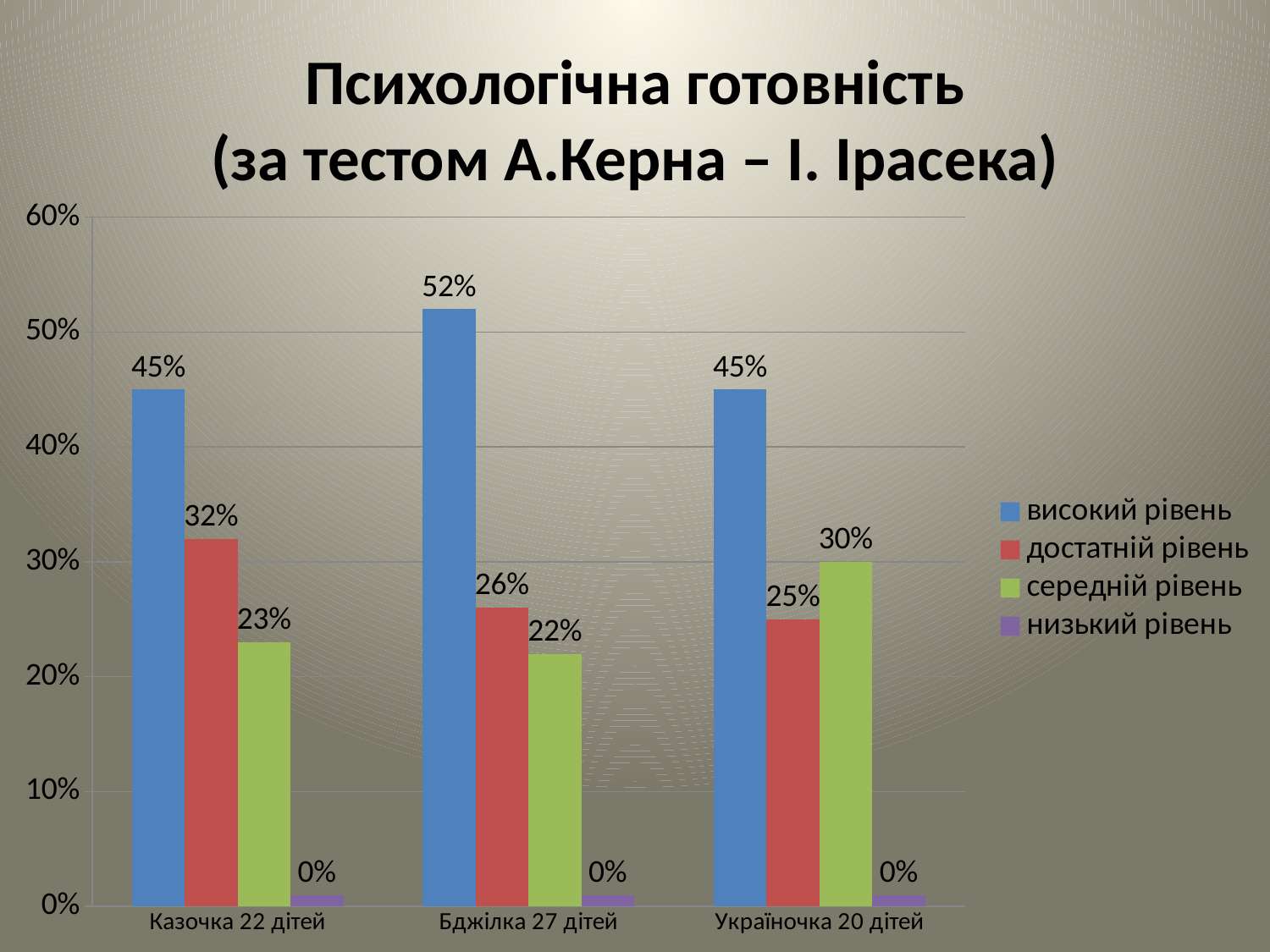
Which group has the lowest value for середній рівень? Бджілка 27 дітей What is the value for низький рівень in the Бджілка 27 дітей group? 0% Which colour represents низький рівень in the legend? purple How many series does the legend list? 4 Which is larger in the Україночка 20 дітей group: достатній рівень or середній рівень? середній рівень What kind of chart is shown on the slide? bar chart Which group has the highest value for високий рівень? Бджілка 27 дітей How many groups are shown on the x axis? 3 What is the value for середній рівень in the Україночка 20 дітей group? 30% What is the value for достатній рівень in the Казочка 22 дітей group? 32% What is the value for високий рівень in the Бджілка 27 дітей group? 52% What is the difference between високий рівень and достатній рівень in the Казочка 22 дітей group? 13%